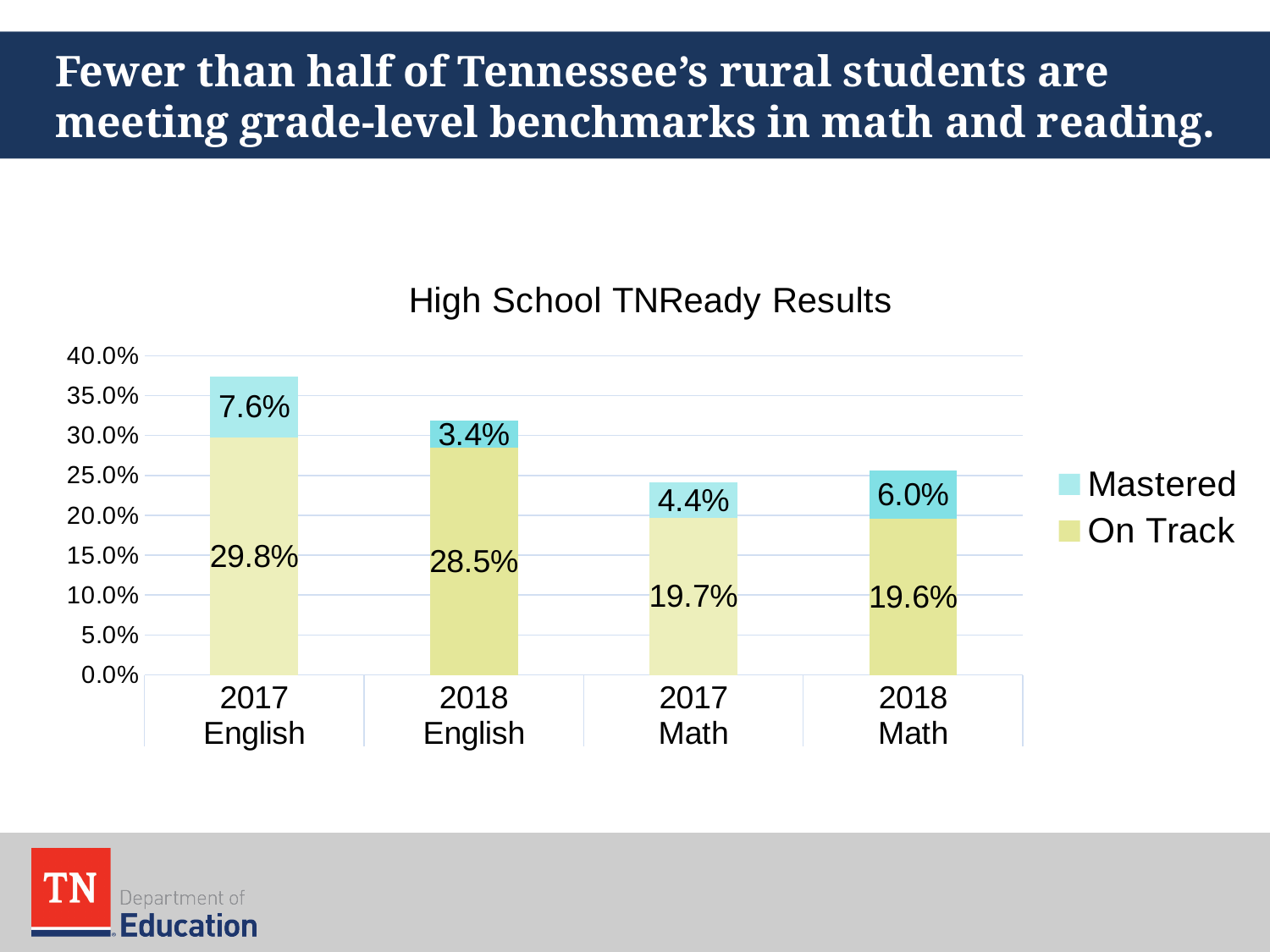
How many series does the legend list? 2 Which category has the highest On Track value? 2017 English What kind of chart is shown? Stacked bar chart What is the difference between the Mastered values for 2017 English and 2018 English? 4.2% Which is larger, the Mastered value for 2018 Math or the Mastered value for 2017 Math? 2018 Math What is the Mastered value for 2018 Math? 6.0% What is the total of the stacked bar for 2018 English? 31.9% What is the title of the chart? High School TNReady Results Is the total height of the 2017 English bar greater or less than 35.0%? greater What is the On Track value for 2017 English? 29.8% Which category has the lowest Mastered value? 2018 English How many categories are shown on the x axis? 4